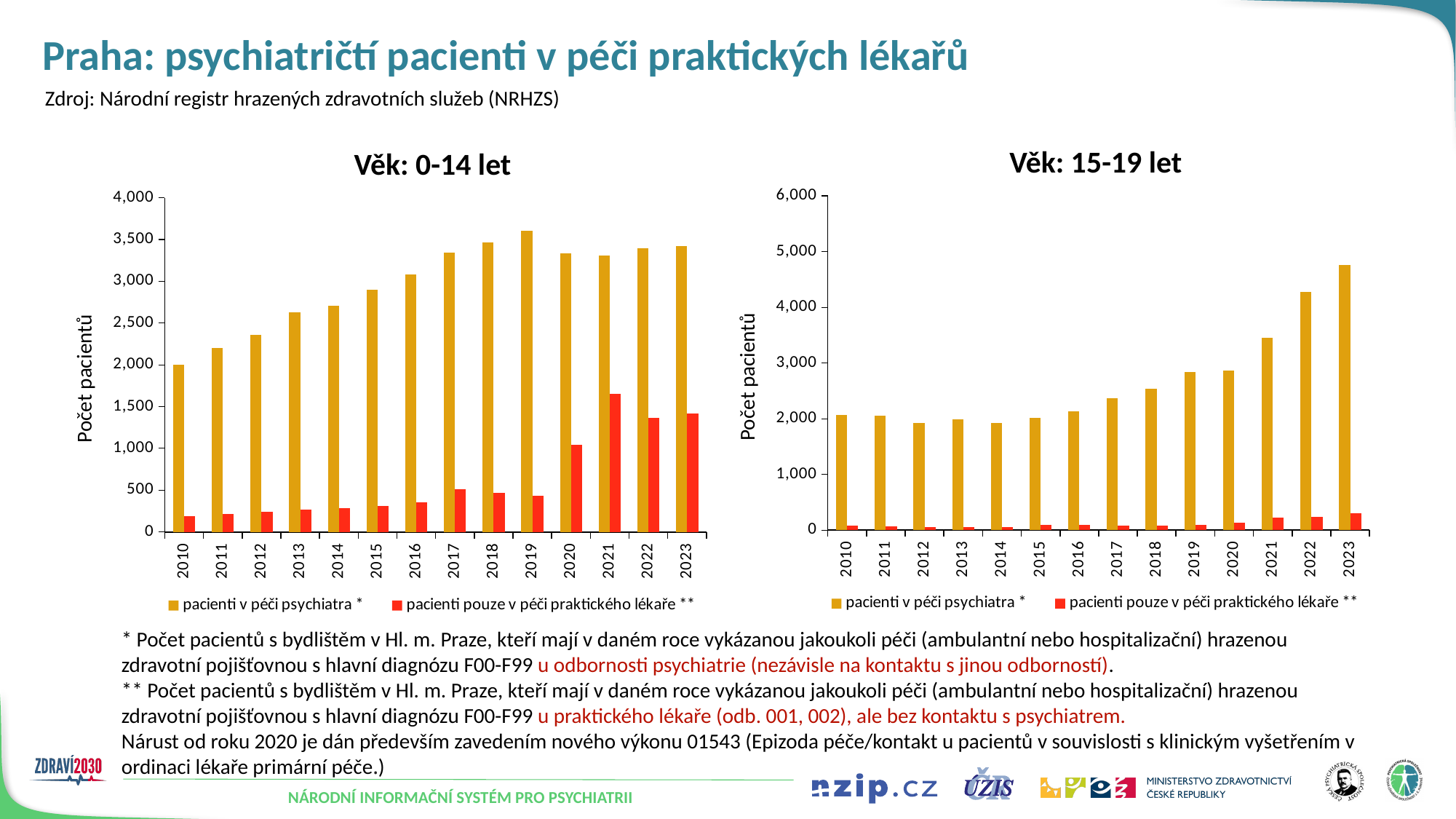
How many years are shown on the x axis of the 'Věk: 15-19 let' chart? 14 In the 'Věk: 0-14 let' chart, which year has the highest value for 'pacienti pouze v péči praktického lékaře **'? 2021 In the 'Věk: 0-14 let' chart, which year has the highest value for 'pacienti v péči psychiatra *'? 2019 In the 'Věk: 15-19 let' chart, is the value for 'pacienti v péči psychiatra *' in 2022 greater or less than 4,000? greater In the 'Věk: 15-19 let' chart, is the value for 'pacienti v péči psychiatra *' in 2023 greater or less than 5,000? less In the 'Věk: 15-19 let' chart, which is larger for 'pacienti v péči psychiatra *': 2019 or 2021? 2021 In the 'Věk: 0-14 let' chart, is the value for 'pacienti pouze v péči praktického lékaře **' in 2021 greater or less than 1,500? greater In the 'Věk: 15-19 let' chart, which year has the highest value for 'pacienti v péči psychiatra *'? 2023 In the 'Věk: 0-14 let' chart, which year has the lowest value for 'pacienti v péči psychiatra *'? 2010 How many series does the legend of the 'Věk: 0-14 let' chart list? 2 What type of chart is used for the 'Věk: 0-14 let' chart? bar chart